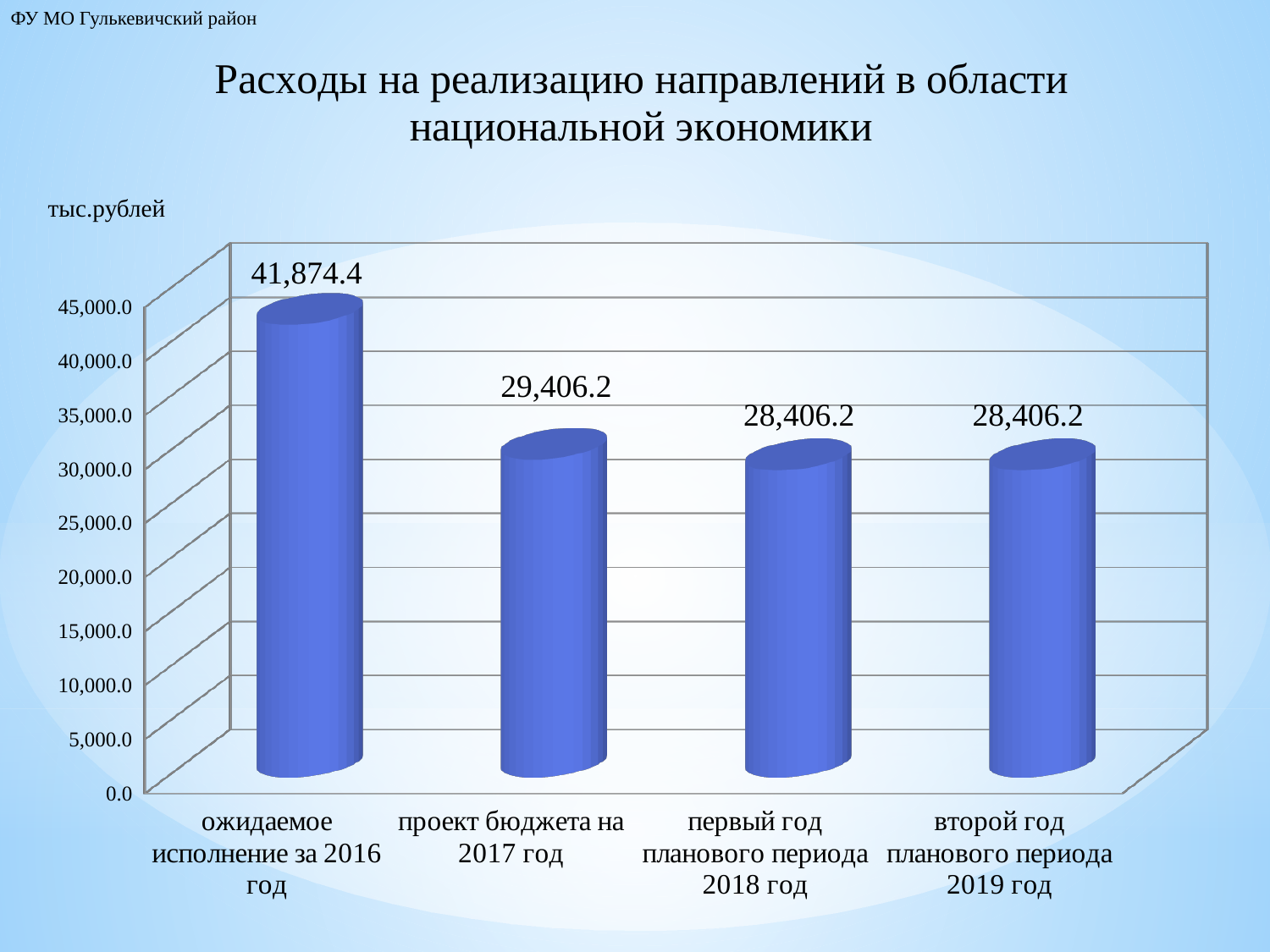
What is the difference between the values for 'ожидаемое исполнение за 2016 год' and 'проект бюджета на 2017 год'? 12,468.2 What is the value for 'проект бюджета на 2017 год'? 29,406.2 How many categories are shown on the chart? 4 What kind of chart is shown on the slide? bar chart Do the values generally rise or fall from left to right along the x axis? fall What is the difference between the values for 'проект бюджета на 2017 год' and 'первый год планового периода 2018 год'? 1,000.0 What is the value for 'ожидаемое исполнение за 2016 год'? 41,874.4 Which is larger: the value for 'ожидаемое исполнение за 2016 год' or the value for 'проект бюджета на 2017 год'? ожидаемое исполнение за 2016 год What is the value for 'второй год планового периода 2019 год'? 28,406.2 What unit is indicated above the chart's vertical axis? тыс.рублей Which category has the highest value? ожидаемое исполнение за 2016 год What is the value for 'первый год планового периода 2018 год'? 28,406.2